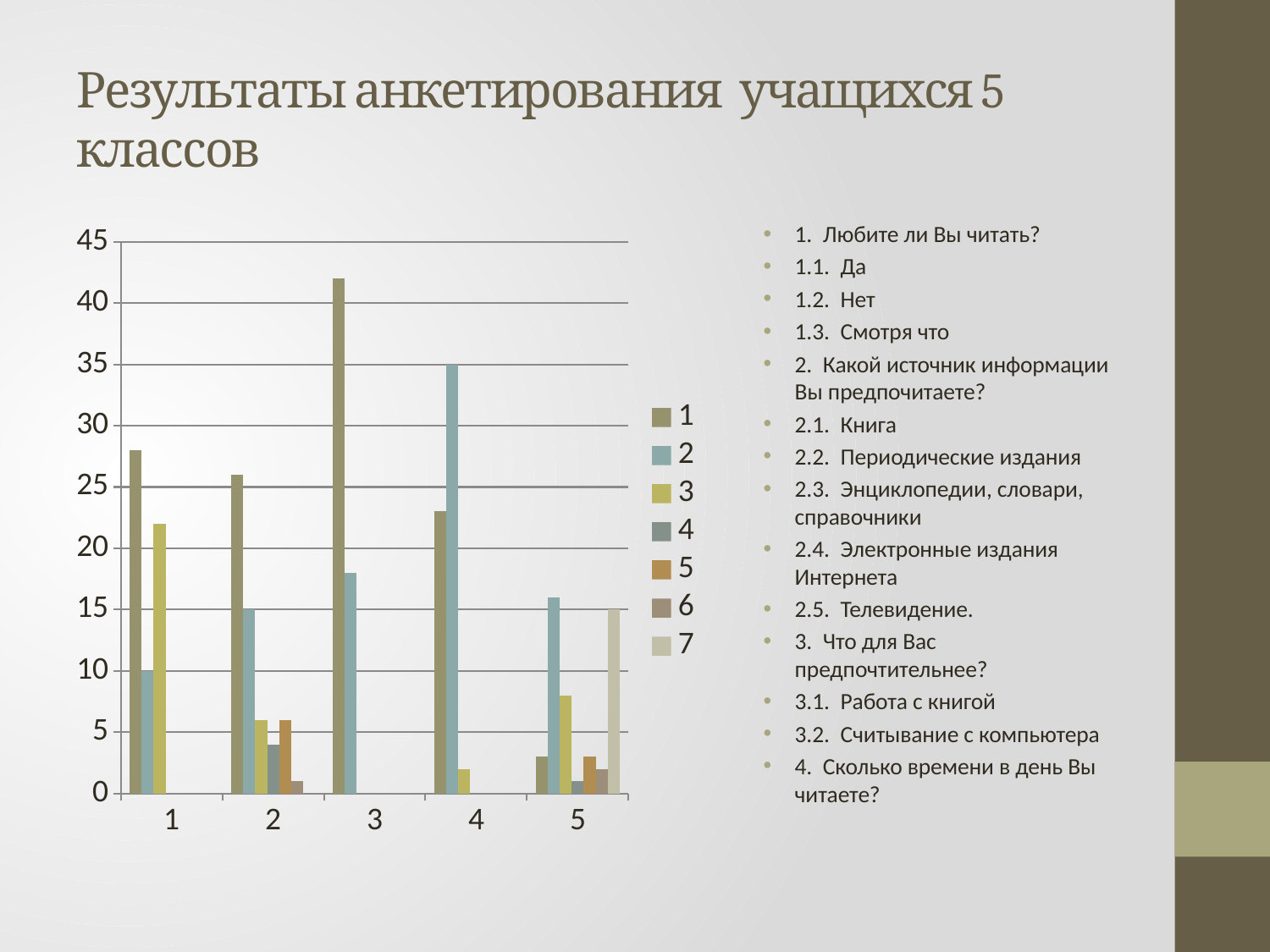
How many categories are shown on the x axis of the chart? 5 Is the value for series 1 in category 3 greater or less than 40? greater Which category has the tallest bar for series 2? 4 Which category has the lowest value for series 1? 5 In category 4, which is larger: the value for series 1 or the value for series 2? series 2 Is the value for series 1 in category 5 greater or less than 5? less In category 1, which is larger: the value for series 2 or the value for series 3? series 3 Which category has the tallest bar for series 1? 3 What kind of chart is shown on the slide? bar chart Is the value for series 3 in category 5 greater or less than 10? less How many series does the chart legend list? 7